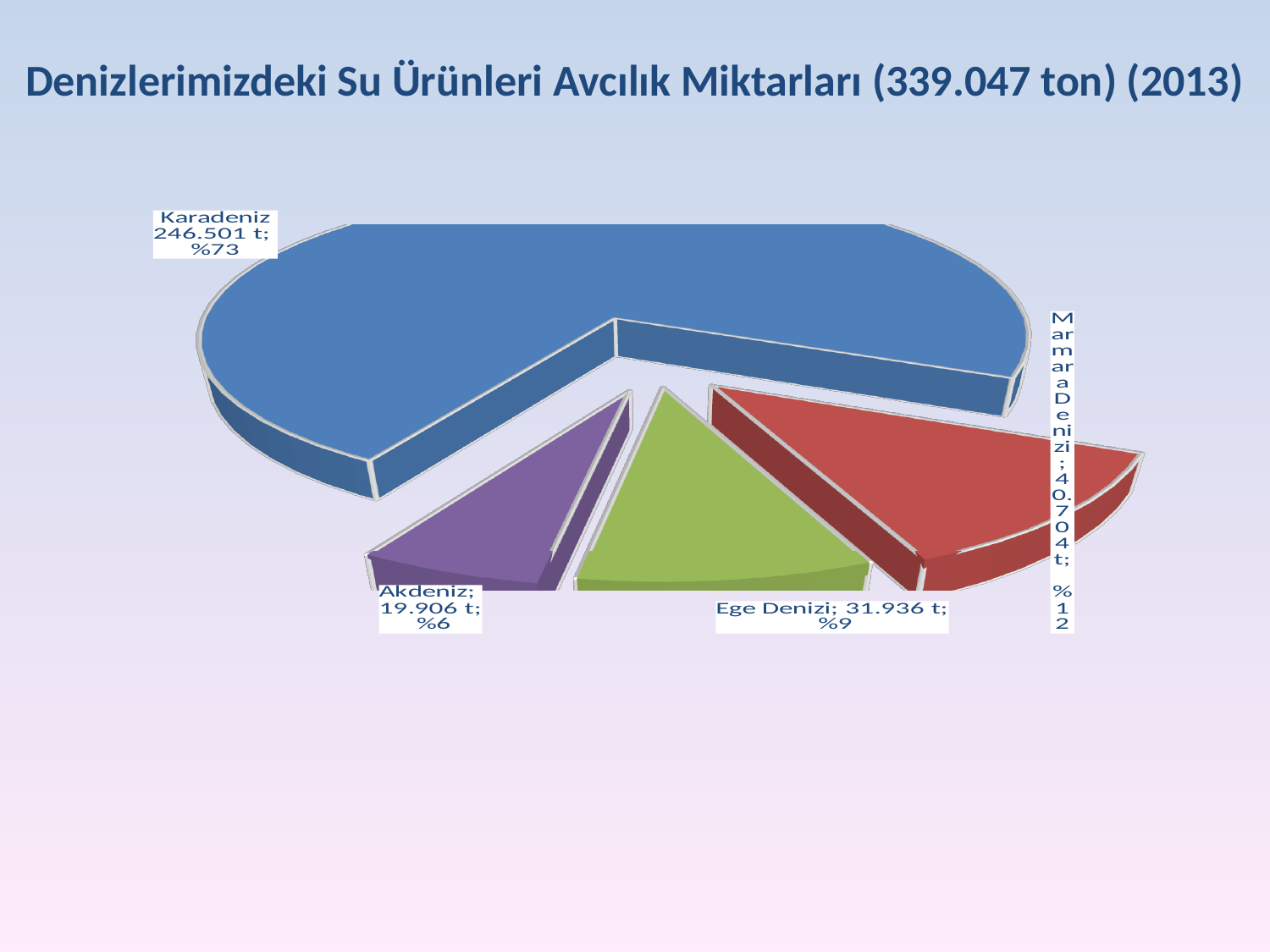
What is the catch amount for Karadeniz? 246.501 t Which sea has the largest catch amount? Karadeniz Which has a larger catch amount, Ege Denizi or Akdeniz? Ege Denizi What type of chart is shown on the slide? Pie chart What is the difference in catch amount between Marmara Denizi and Ege Denizi? 8.768 t Which sea has the smallest catch amount? Akdeniz What is the catch amount for Marmara Denizi? 40.704 t How many slices does the pie chart have? 4 What share of the pie does Ege Denizi represent? %9 What share of the pie does Karadeniz represent? %73 What is the catch amount for Akdeniz? 19.906 t What is the catch amount for Ege Denizi? 31.936 t